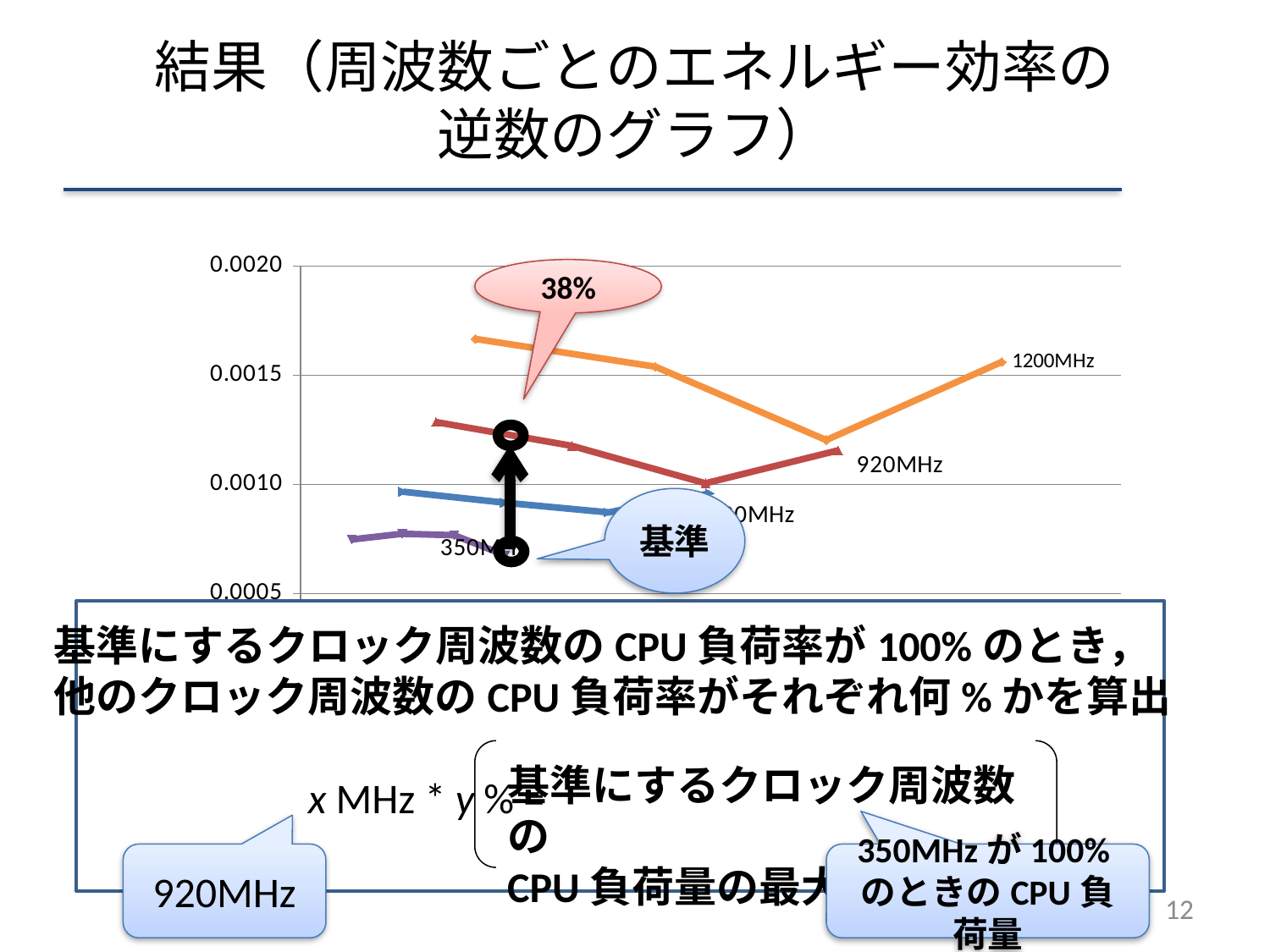
What percentage is written in the red callout above the chart? 38% What is the highest value shown on the vertical axis of the chart? 0.0020 Which frequency series has the highest values in the chart? 1200MHz What kind of chart is shown on the slide? line chart Is the first (leftmost) value of the 1200MHz line greater or less than 0.0015? greater Is the lowest point of the 1200MHz line greater or less than 0.0010? greater At the right end of the chart, which line is higher: 1200MHz or 920MHz? 1200MHz Is the first (leftmost) value of the 920MHz line greater or less than 0.0010? greater How many lines (frequency series) are plotted in the chart? 4 Which frequency series has the lowest values in the chart? 350MHz